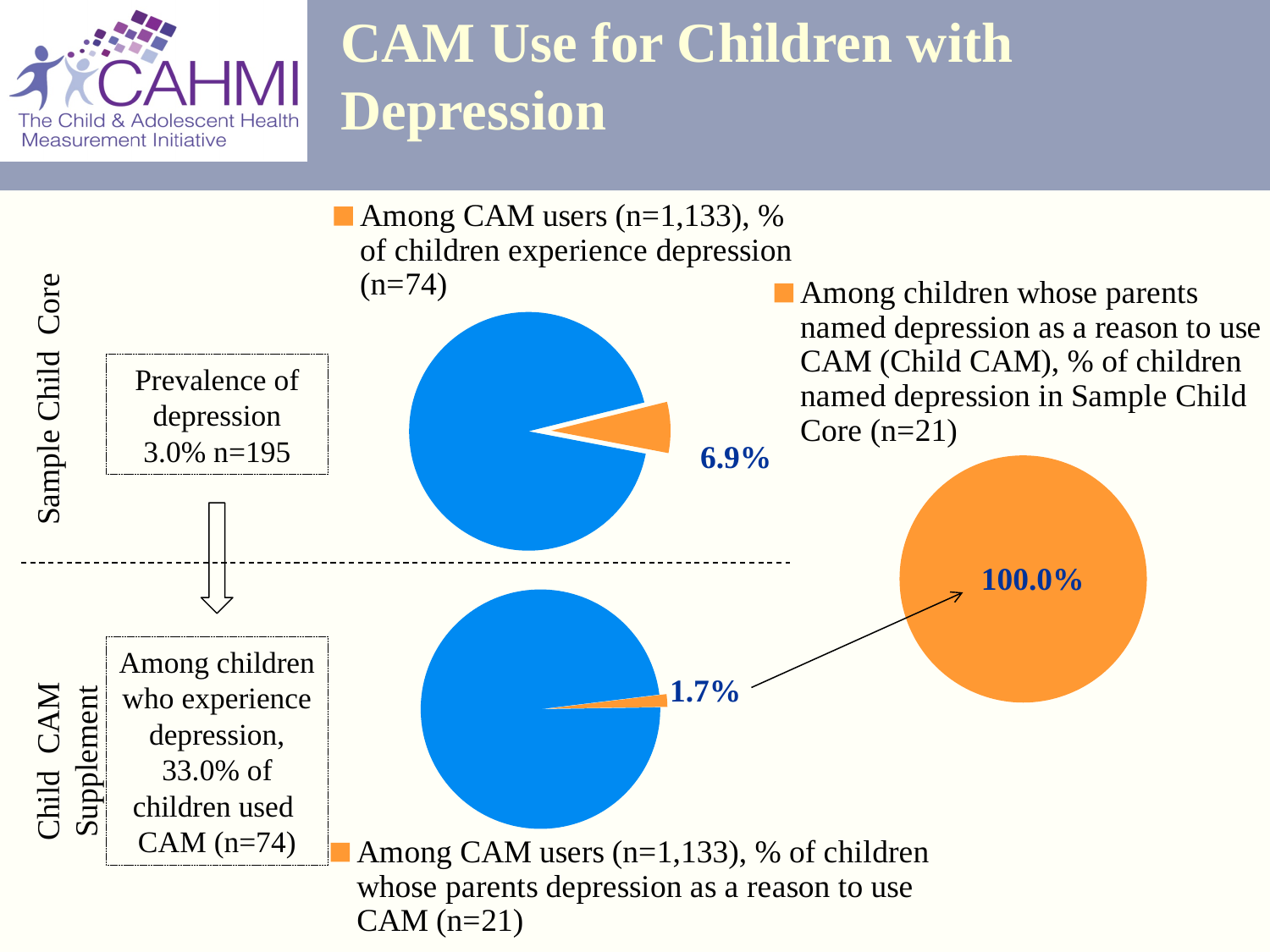
What type of charts are shown on the slide? pie charts Which of the three pie charts shows the smallest orange slice? the bottom-middle one (1.7%) In the pie chart on the right, what share of the pie does the orange slice take up? 100.0% In the pie chart on the right, what percentage is labelled on the orange slice? 100.0% What colour is the slice labelled 6.9% in the top-middle pie chart? orange Which pie chart has the larger orange slice, the top-middle one or the bottom-middle one? the top-middle one In the top-middle pie chart, what percentage is shown for the orange slice (children who experience depression among CAM users)? 6.9% In the top-middle pie chart, is the orange slice's share greater or less than 10%? less In the bottom-middle pie chart, what percentage is shown for the orange slice (children whose parents named depression as a reason to use CAM)? 1.7% How many pie charts are on the slide? 3 What is the difference between the orange slice values of the top-middle pie chart (6.9%) and the bottom-middle pie chart (1.7%)? 5.2% What is the title of the slide containing the pie charts? CAM Use for Children with Depression